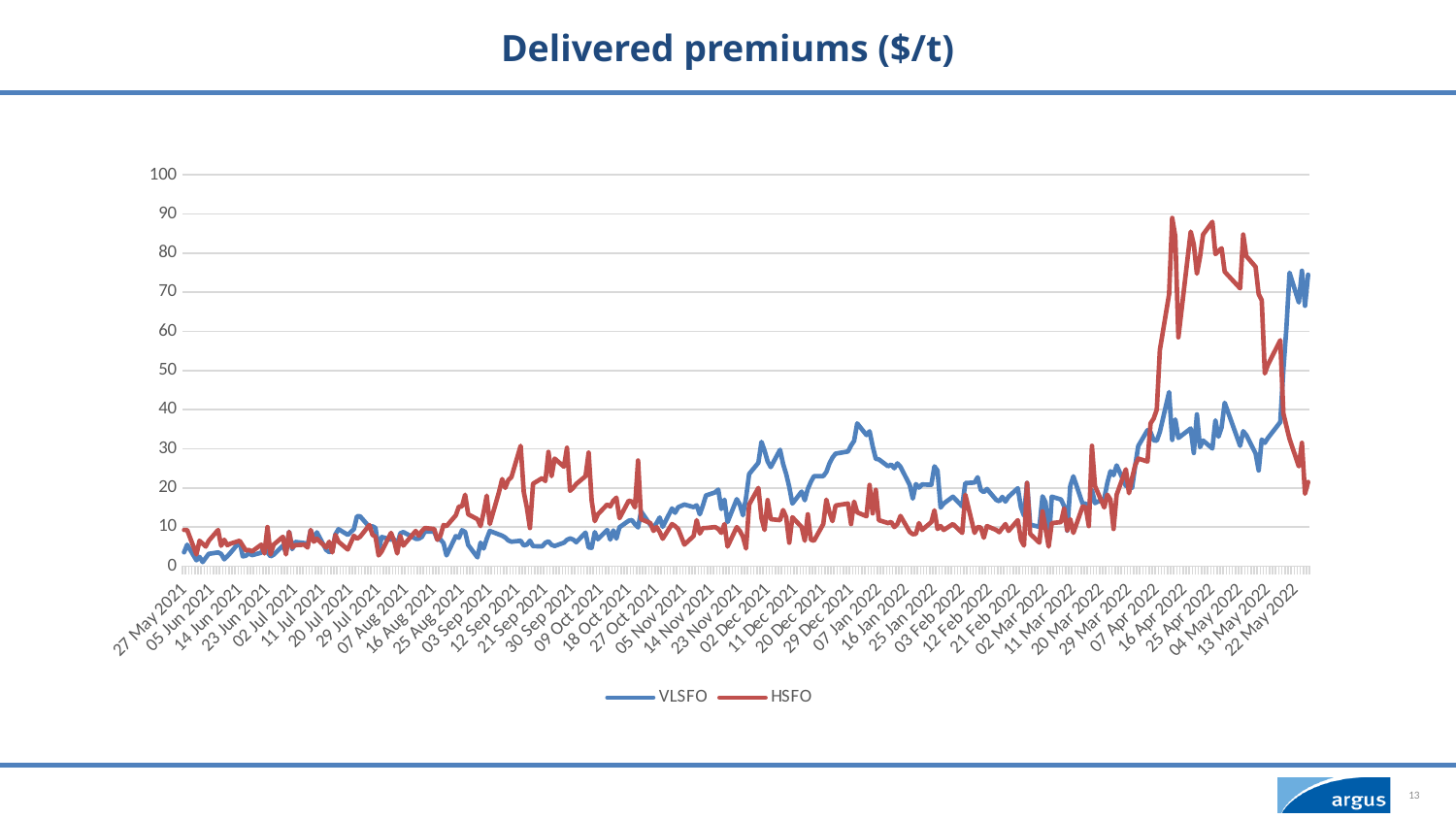
How many series does the legend list? 2 Overall, do the delivered premiums rise or fall from May 2021 to May 2022? rise Is the peak value of the HSFO series in April 2022 greater or less than 80? greater What is the title of the chart? Delivered premiums ($/t) Is the VLSFO value in early June 2021 greater or less than 10? less Around 29 Dec 2021, which series has the higher value, VLSFO or HSFO? VLSFO Which series reaches the higher peak value over the whole period, VLSFO or HSFO? HSFO Around 16 Apr 2022, which series has the higher value, VLSFO or HSFO? HSFO Is the highest VLSFO value in May 2022 greater or less than 60? greater What kind of chart is shown on the slide? line chart Which two series are listed in the legend? VLSFO and HSFO